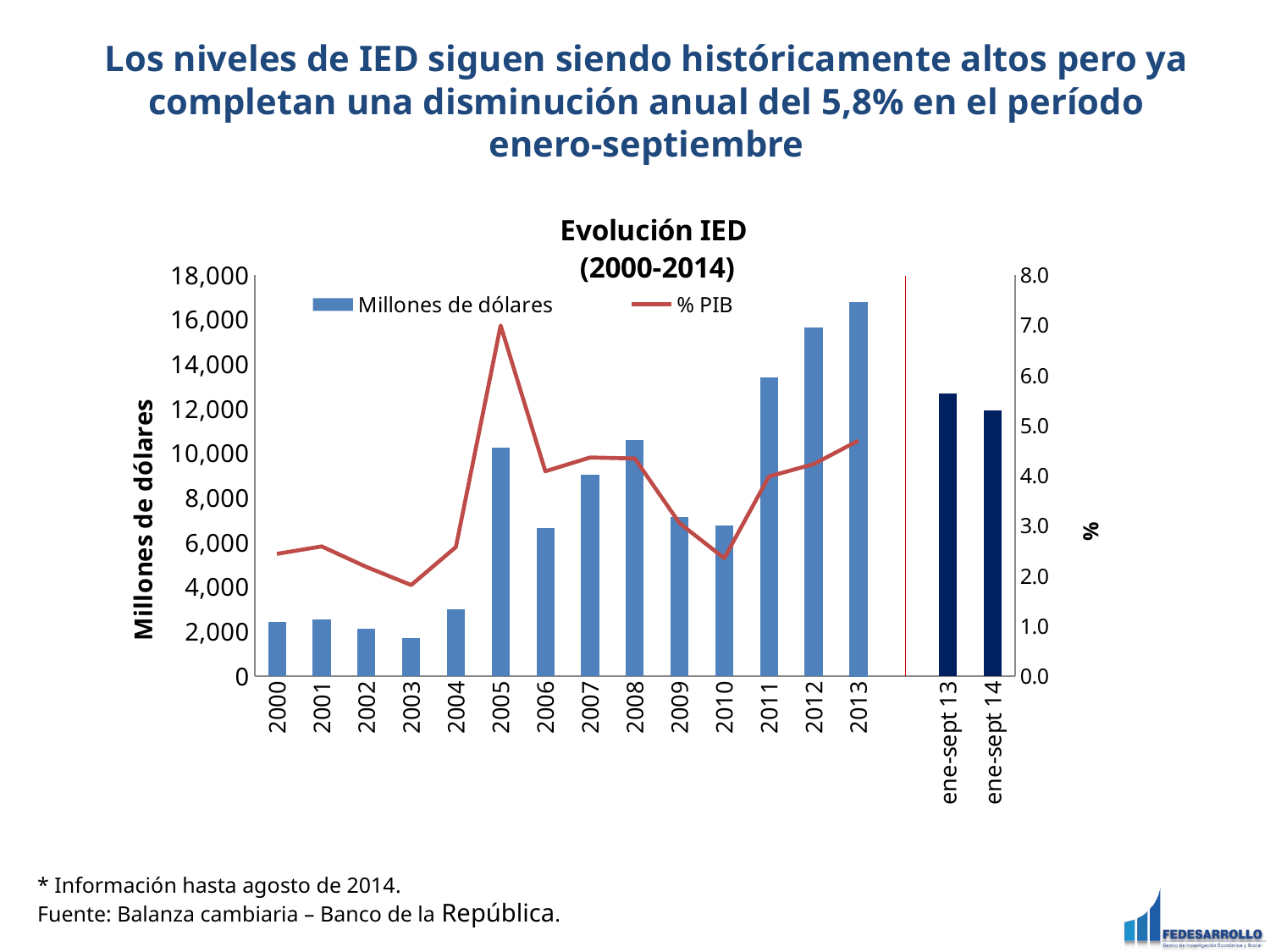
Which year has the lowest bar for Millones de dólares? 2003 How many categories are shown on the x axis? 16 Which year has the highest bar for Millones de dólares? 2013 Is the % PIB value for 2005 greater or less than 6.0? greater In which year does the % PIB line reach its peak? 2005 What kind of chart is shown on the slide? A combined bar and line chart What are the two series named in the legend? Millones de dólares and % PIB Is the Millones de dólares value for 2004 greater or less than 4,000? less How many series does the legend list? 2 Is the Millones de dólares value for 2013 greater or less than 16,000? greater Which bar is taller, ene-sept 13 or ene-sept 14? ene-sept 13 Do the Millones de dólares bars rise or fall from 2011 to 2013? rise